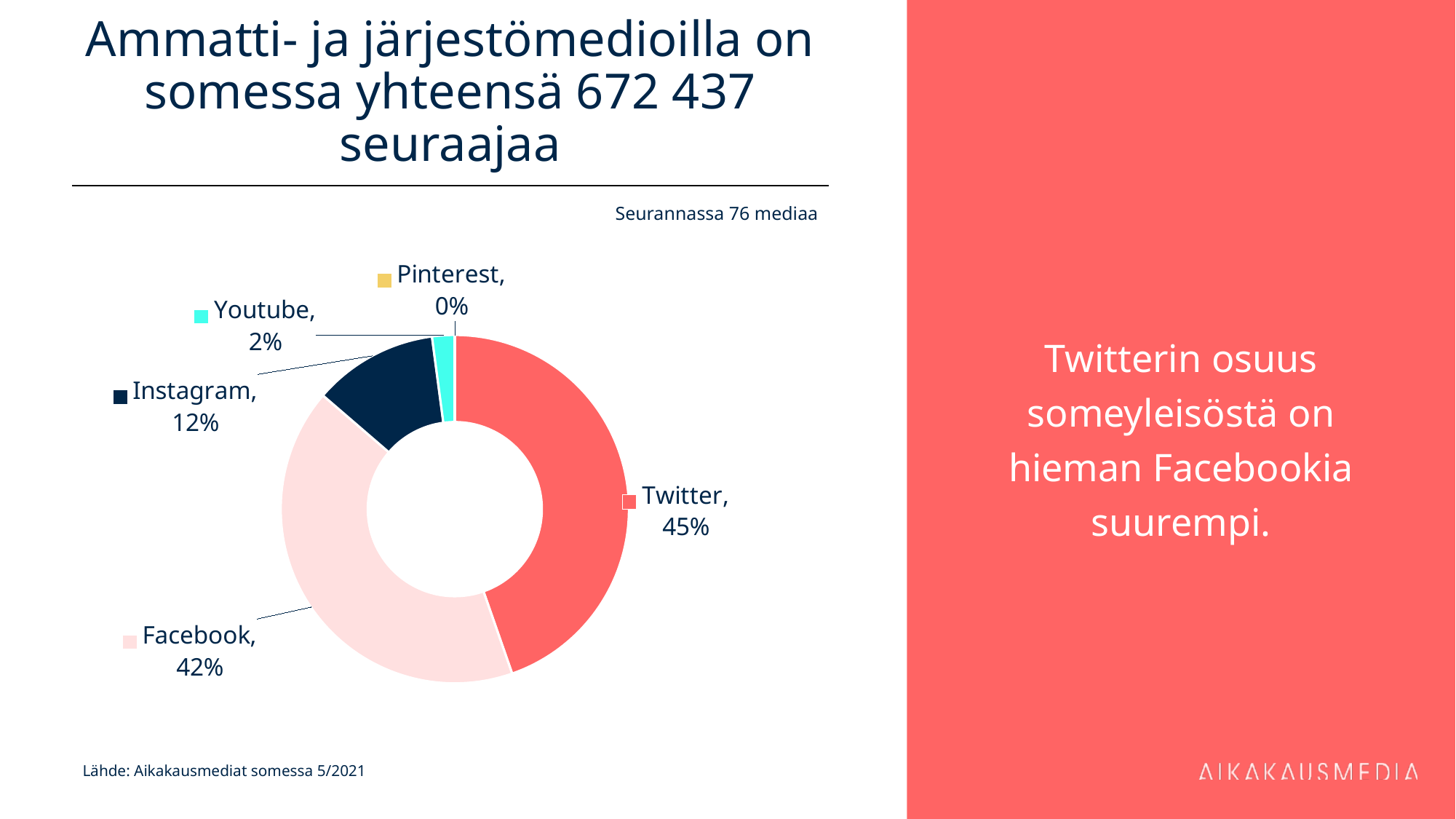
What share of the pie does Facebook hold? 42% What share of the pie does Twitter hold? 45% What is the value shown for Youtube? 2% What is the difference in percentage points between Twitter and Facebook? 3 How many platforms are shown in the chart? 5 What is the title of the chart on the slide? Ammatti- ja järjestömedioilla on somessa yhteensä 672 437 seuraajaa Which platform has the largest share? Twitter What is the value shown for Instagram? 12% Which is larger, the share for Instagram or the share for Youtube? Instagram What kind of chart is shown on the slide? Pie chart (doughnut) Which platform has the smallest share? Pinterest What is the value shown for Pinterest? 0%